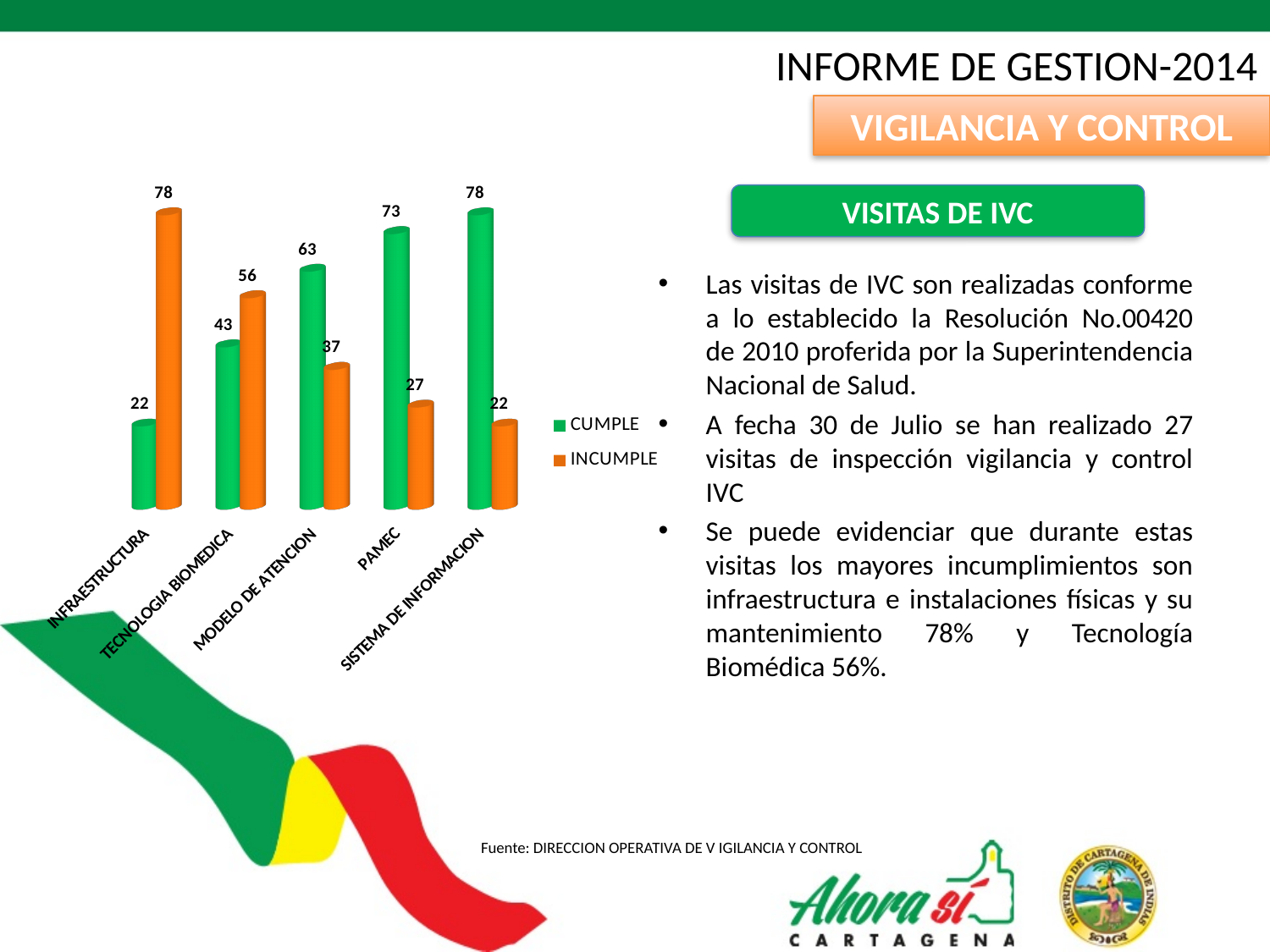
Which category has the highest INCUMPLE value? INFRAESTRUCTURA Which is larger for MODELO DE ATENCION, CUMPLE or INCUMPLE? CUMPLE What is the INCUMPLE value for MODELO DE ATENCION? 37 How many series does the legend list? 2 What is the INCUMPLE value for TECNOLOGIA BIOMEDICA? 56 What is the CUMPLE value for PAMEC? 73 Which category has the lowest CUMPLE value? INFRAESTRUCTURA What is the CUMPLE value for INFRAESTRUCTURA? 22 What is the difference between the INCUMPLE and CUMPLE values for INFRAESTRUCTURA? 56 How many categories are shown on the x axis? 5 What kind of chart is shown on the slide? Bar chart Which colour represents the INCUMPLE series? Orange